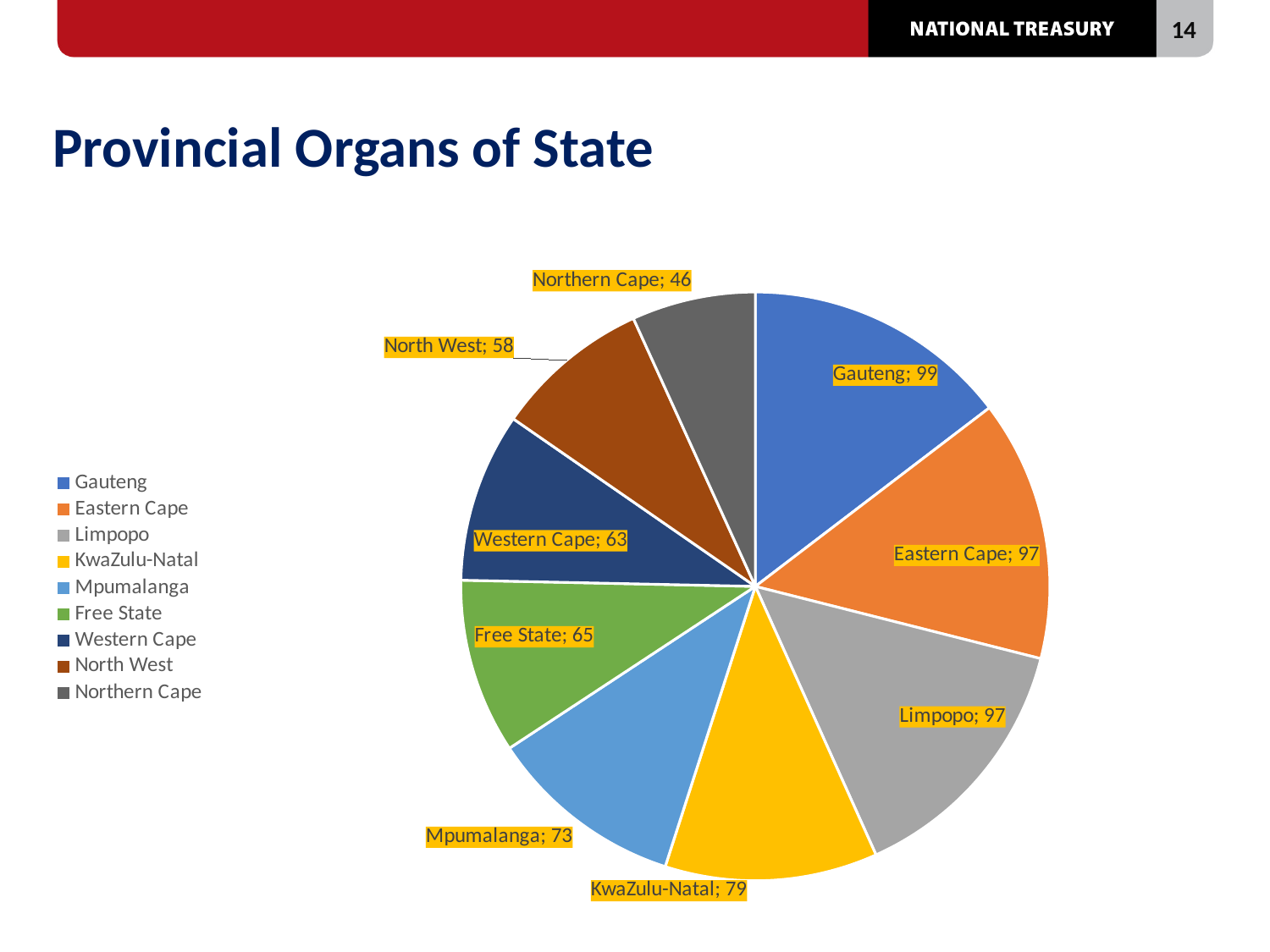
Which is larger, the value for North West or the value for Western Cape? Western Cape What is the difference between the values for Gauteng and Northern Cape? 53 What kind of chart is shown on the slide? Pie chart How many provinces are shown in the pie chart? 9 What is the value for Western Cape? 63 What is the difference between the values for Mpumalanga and Free State? 8 What is the value for KwaZulu-Natal? 79 What is the title of the slide containing the chart? Provincial Organs of State What is the total of all the slices in the pie chart? 677 Which province has the largest slice? Gauteng What is the value for Gauteng? 99 Which province has the smallest slice? Northern Cape